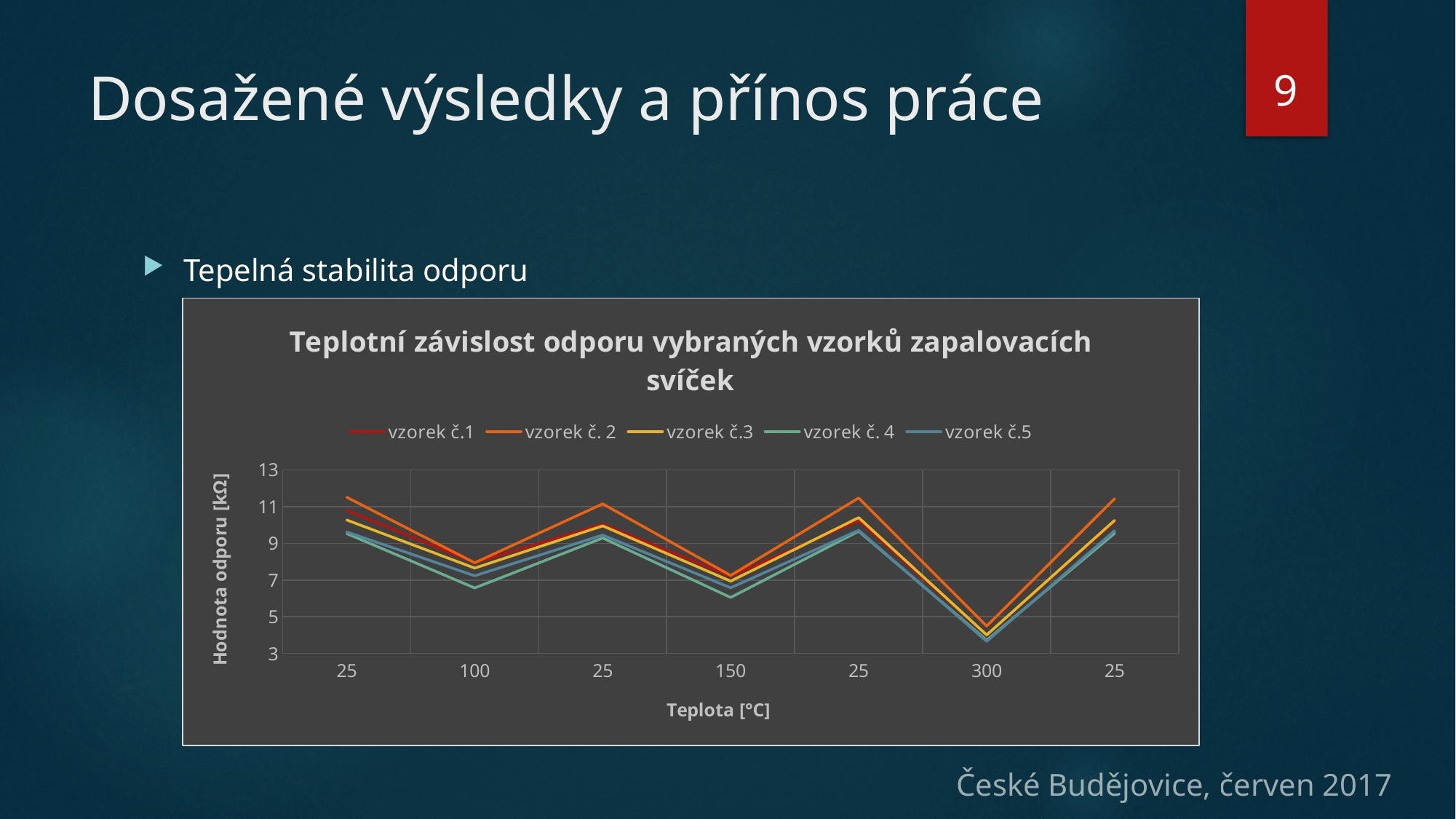
What is the label of the y axis? Hodnota odporu [kΩ] Is the value for vzorek č. 4 at 300 °C greater or less than 5? less Is the value for vzorek č. 2 at 100 °C greater or less than 7? greater What kind of chart is shown on the slide? line chart Which series has the highest value at the first 25 °C point? vzorek č. 2 What is the title of the chart? Teplotní závislost odporu vybraných vzorků zapalovacích svíček How many temperature points are plotted along the x axis? 7 At which temperature does vzorek č. 2 reach its lowest value? 300 Is the value for vzorek č. 2 at the first 25 °C point greater or less than 11? greater Do the values rise or fall between the first 25 °C point and the 100 °C point? fall How many series does the legend list? 5